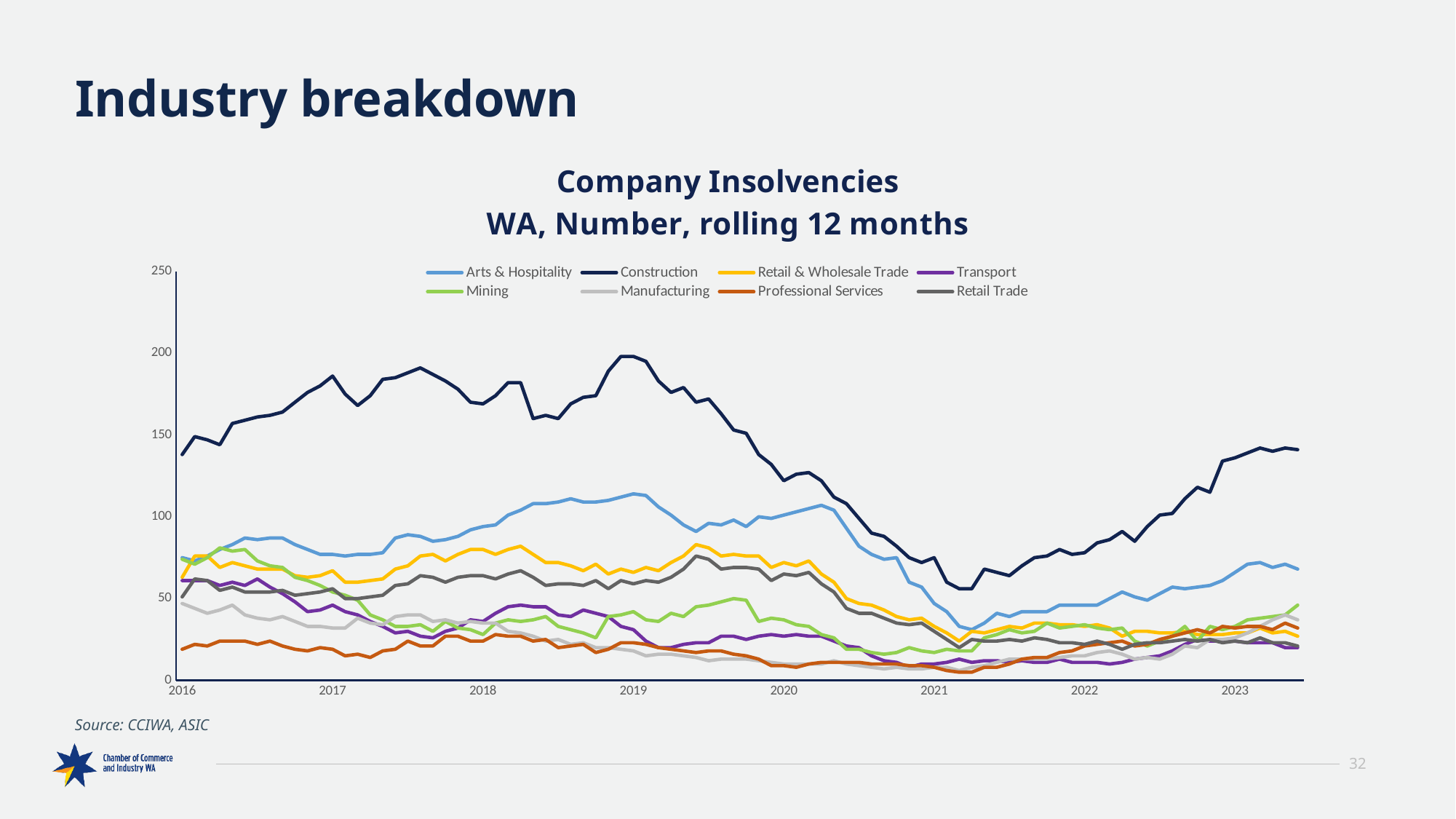
What kind of chart is shown on the slide? line chart What is the title of the chart? Company Insolvencies WA, Number, rolling 12 months Is the peak value for Construction around 2019 greater or less than 150? greater Is the value for Professional Services at the start of 2016 greater or less than 50? less Is the value for Construction at the start of 2016 greater or less than 100? greater Does the Construction series rise or fall between 2019 and 2021? fall Does the Construction series rise or fall between 2021 and 2023? rise How many series does the legend list? 8 Which series has the highest values for most of the period shown? Construction Which series has the lowest value at the start of 2016? Professional Services